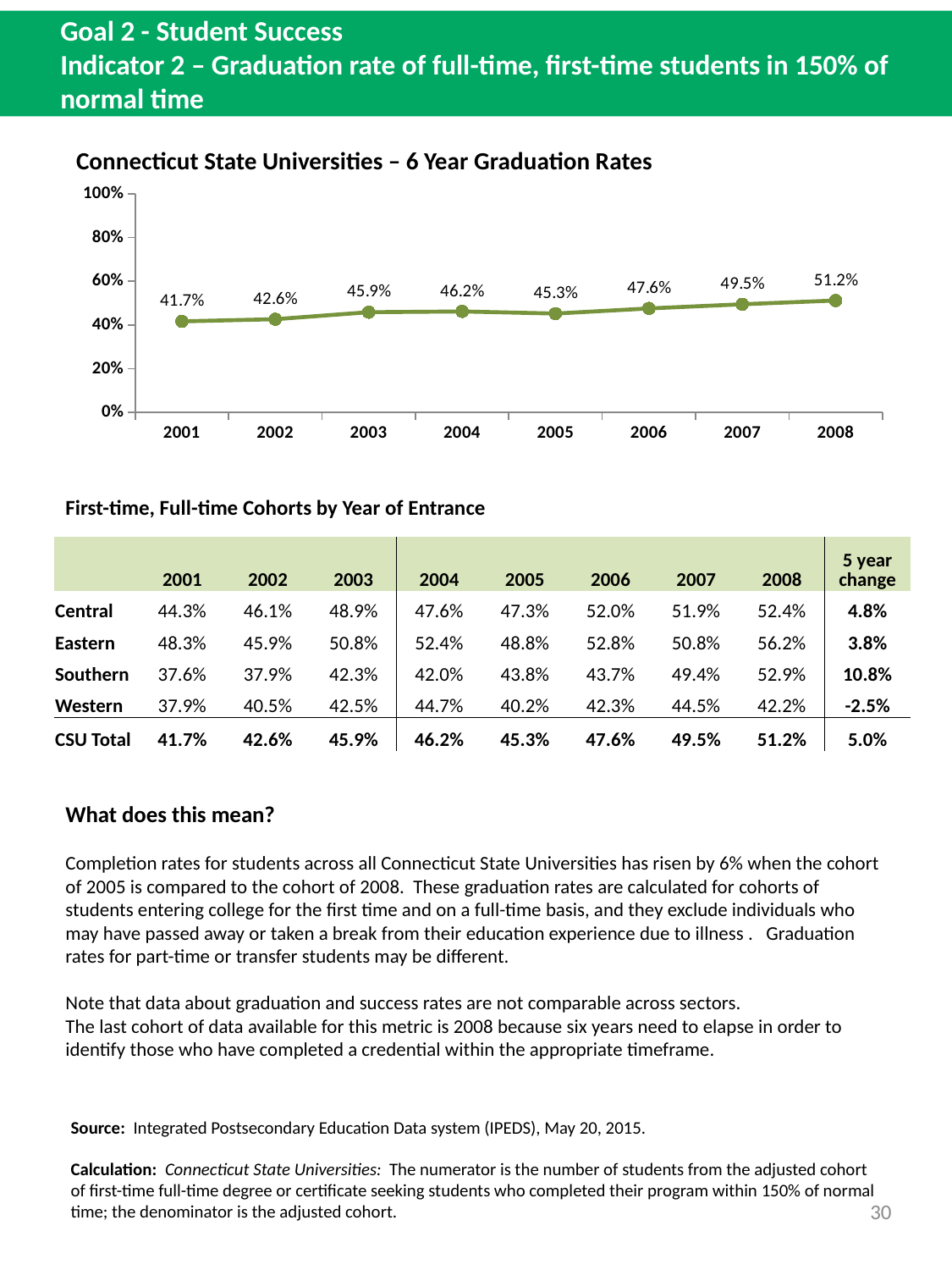
What is the 6 year graduation rate shown for 2008? 51.2% What is the title of the chart? Connecticut State Universities – 6 Year Graduation Rates What is the 6 year graduation rate shown for 2001? 41.7% How many years are plotted on the chart? 8 Which year has the highest 6 year graduation rate on the chart? 2008 Do the graduation rates generally rise or fall from 2001 to 2008? rise What kind of chart is shown on the slide? line chart Which year has the lowest 6 year graduation rate on the chart? 2001 What is the difference between the graduation rates for 2008 and 2001? 9.5% What is the 6 year graduation rate shown for 2005? 45.3% Is the graduation rate for 2007 greater or less than 40%? greater Which year has a higher graduation rate, 2004 or 2005? 2004